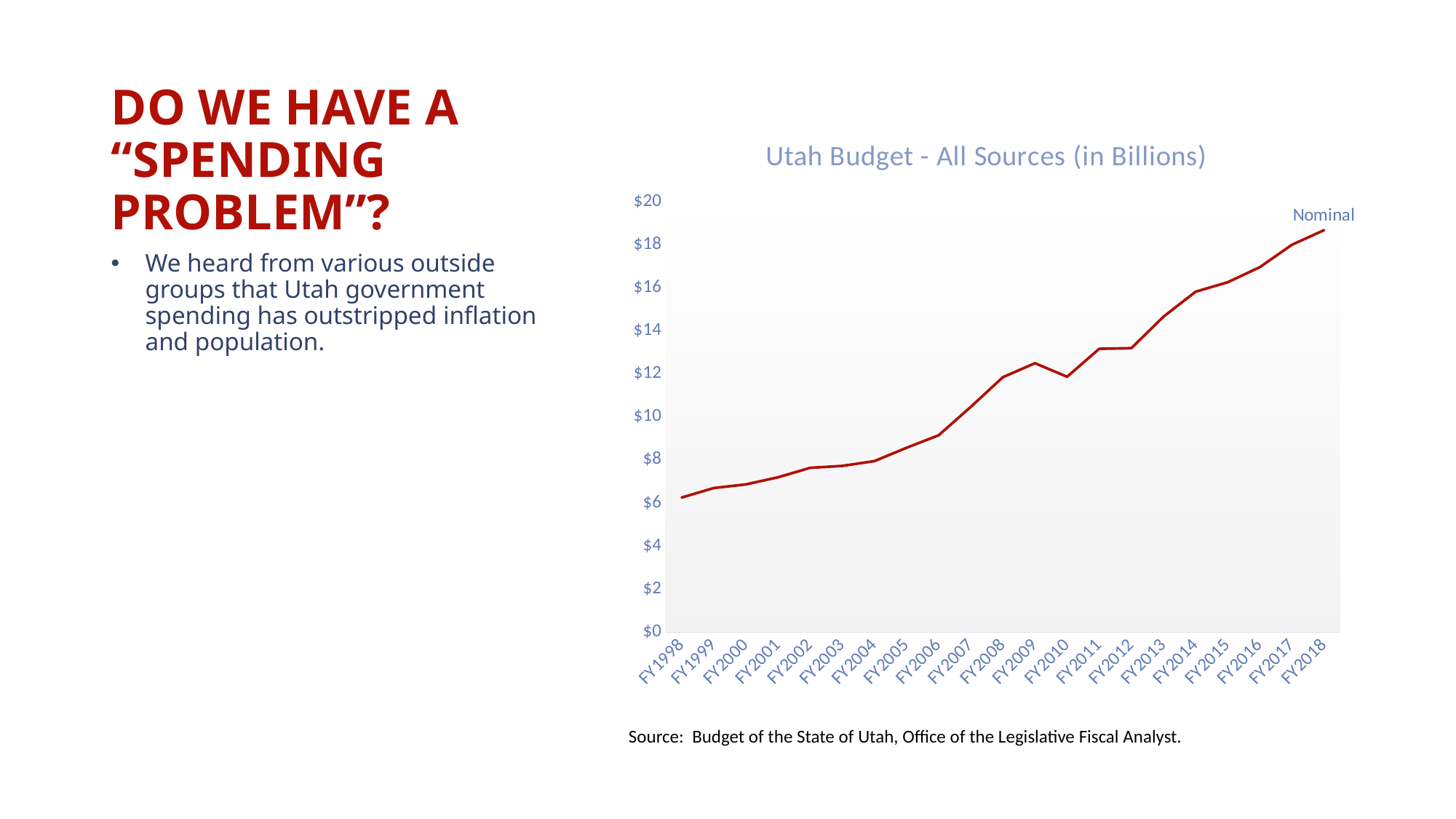
What label is shown next to the line at the right end of the chart? Nominal Is the value for FY1998 greater or less than $8? less Do the budget values generally rise or fall from FY1998 to FY2018? rise Is the value for FY2018 greater or less than $18? greater How many fiscal years are plotted along the x axis? 21 What kind of chart is shown on the slide? line chart Is the value for FY2006 greater or less than $10? less Which fiscal year has the highest budget value? FY2018 Which fiscal year has the lowest budget value? FY1998 Which is larger, the value for FY2009 or the value for FY2010? FY2009 What is the title of the chart? Utah Budget - All Sources (in Billions)